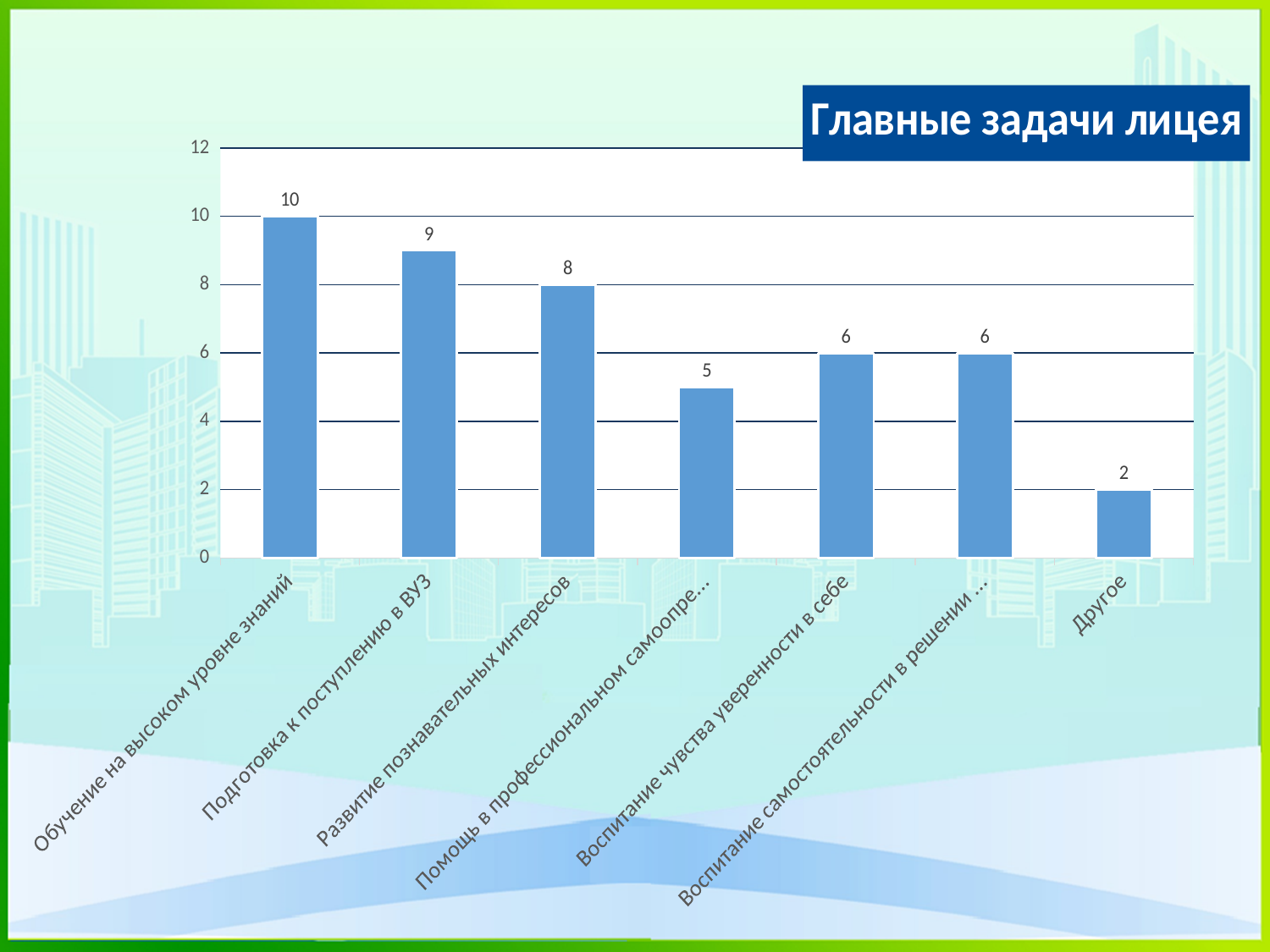
What is the value for "Другое"? 2 What is the value for "Развитие познавательных интересов"? 8 What is the value for "Обучение на высоком уровне знаний"? 10 What is the value for "Воспитание чувства уверенности в себе"? 6 How many categories are shown in the chart? 7 Which category has the lowest value? Другое What is the title shown on the slide above the chart? Главные задачи лицея What type of chart is shown on the slide? bar chart Which category has the highest value? Обучение на высоком уровне знаний What is the value for "Подготовка к поступлению в ВУЗ"? 9 Which is larger: the value for "Подготовка к поступлению в ВУЗ" or the value for "Воспитание чувства уверенности в себе"? Подготовка к поступлению в ВУЗ What is the difference between the values for "Обучение на высоком уровне знаний" and "Другое"? 8